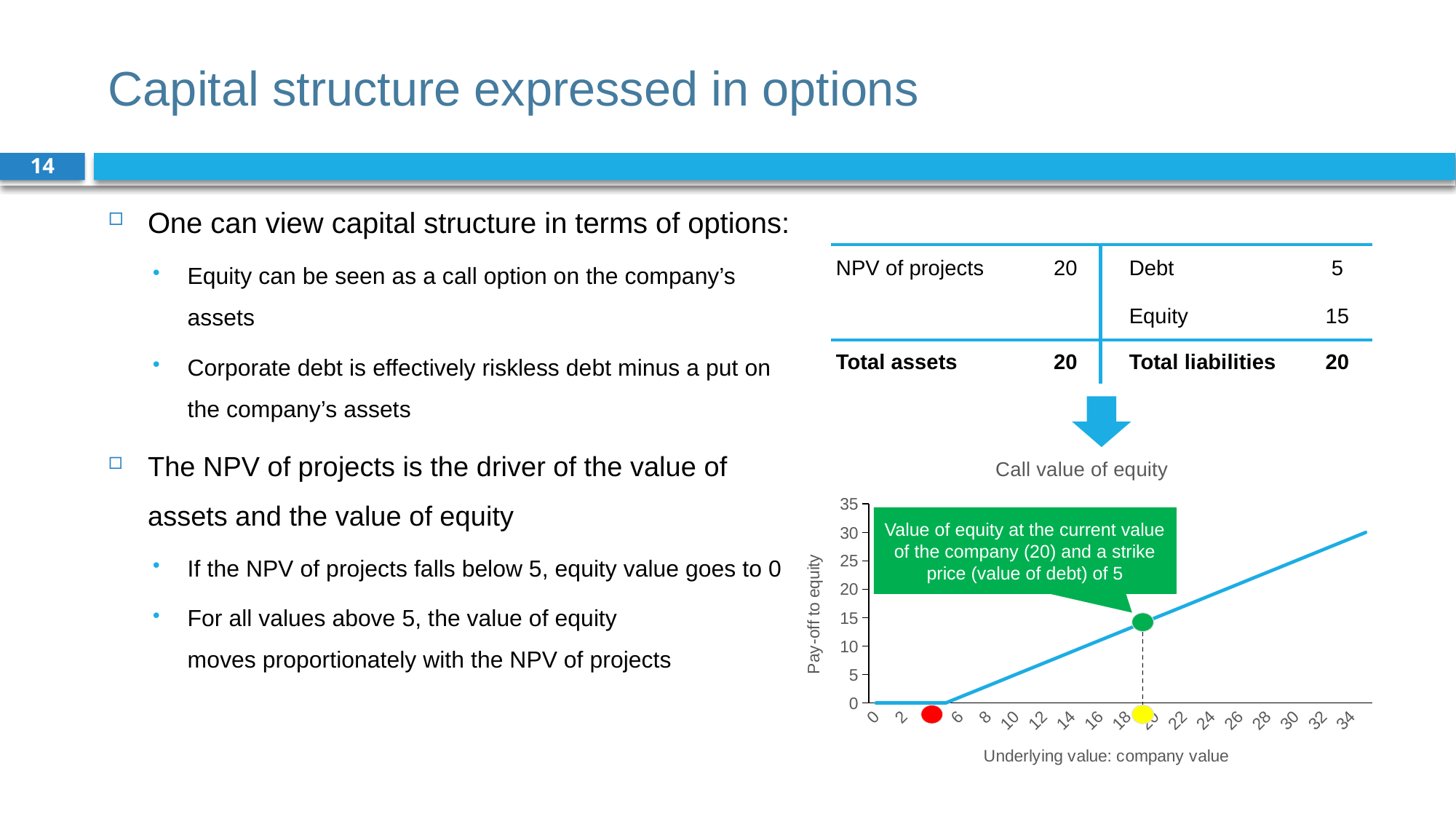
Does the pay-off to equity rise or fall as the company value increases beyond 5? rise Is the pay-off to equity at a company value of 10 greater or less than 10? less Is the pay-off to equity at a company value of 30 greater or less than 20? greater What is the pay-off to equity when the company value is 0? 0 What is the label of the x axis of the chart? Underlying value: company value Which company value gives a larger pay-off to equity, 10 or 30? 30 What is the pay-off to equity when the company value is 20? 15 What kind of chart is shown on the slide? line chart At what company value does the pay-off to equity start to rise above 0? 5 What is the title of the chart? Call value of equity What is the highest value shown on the y axis of the chart? 35 Is the pay-off to equity at a company value of 2 greater or less than 5? less